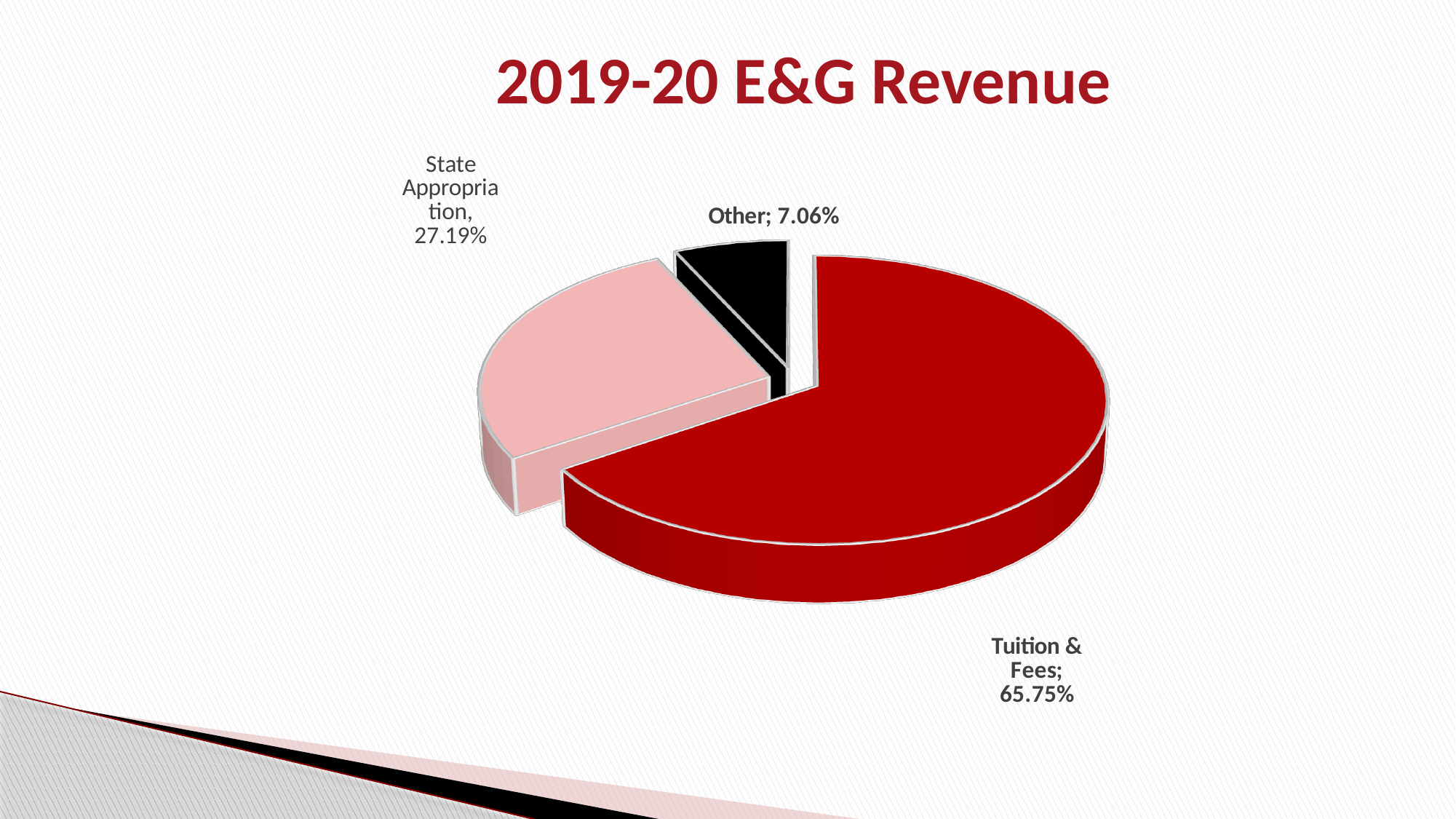
What is the difference in percentage points between the Tuition & Fees share and the State Appropriation share? 38.56 What is the title of the chart on the slide? 2019-20 E&G Revenue What share of 2019-20 E&G Revenue comes from State Appropriation? 27.19% What is the difference in percentage points between the State Appropriation share and the Other share? 20.13 What colour is the Other slice in the pie chart? Black What share of 2019-20 E&G Revenue is labelled Other? 7.06% Which revenue source has the largest share of 2019-20 E&G Revenue? Tuition & Fees Which revenue source has the smallest share of 2019-20 E&G Revenue? Other What kind of chart is shown on the slide? Pie chart Which is larger in 2019-20 E&G Revenue: State Appropriation or Other? State Appropriation What share of 2019-20 E&G Revenue comes from Tuition & Fees? 65.75% How many slices does the 2019-20 E&G Revenue pie chart have? 3